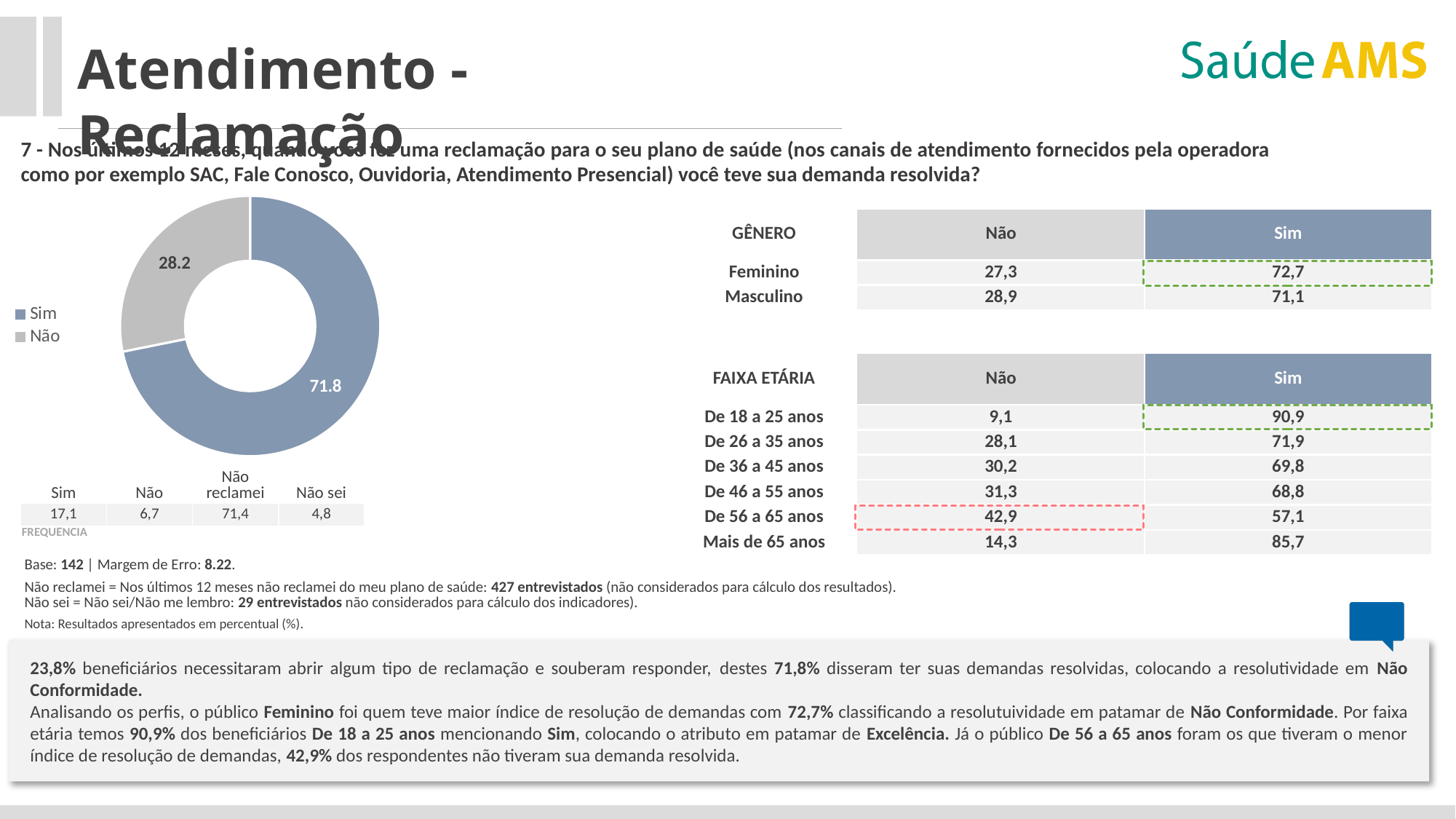
In the donut chart, what is the value for Sim? 71.8 How many slices does the donut chart have? 2 What share of the donut chart does the Sim slice represent? 71.8% In the donut chart, which is larger, Sim or Não? Sim In the donut chart, what is the value for Não? 28.2 Which slice of the donut chart is the largest? Sim What are the two legend entries of the donut chart? Sim and Não Which slice of the donut chart is the smallest? Não What kind of chart is shown on the left of the slide? Donut (pie) chart What is the difference between the Sim and Não values in the donut chart? 43.6 How many entries does the legend of the donut chart list? 2 What colour is the Não slice in the donut chart? Gray